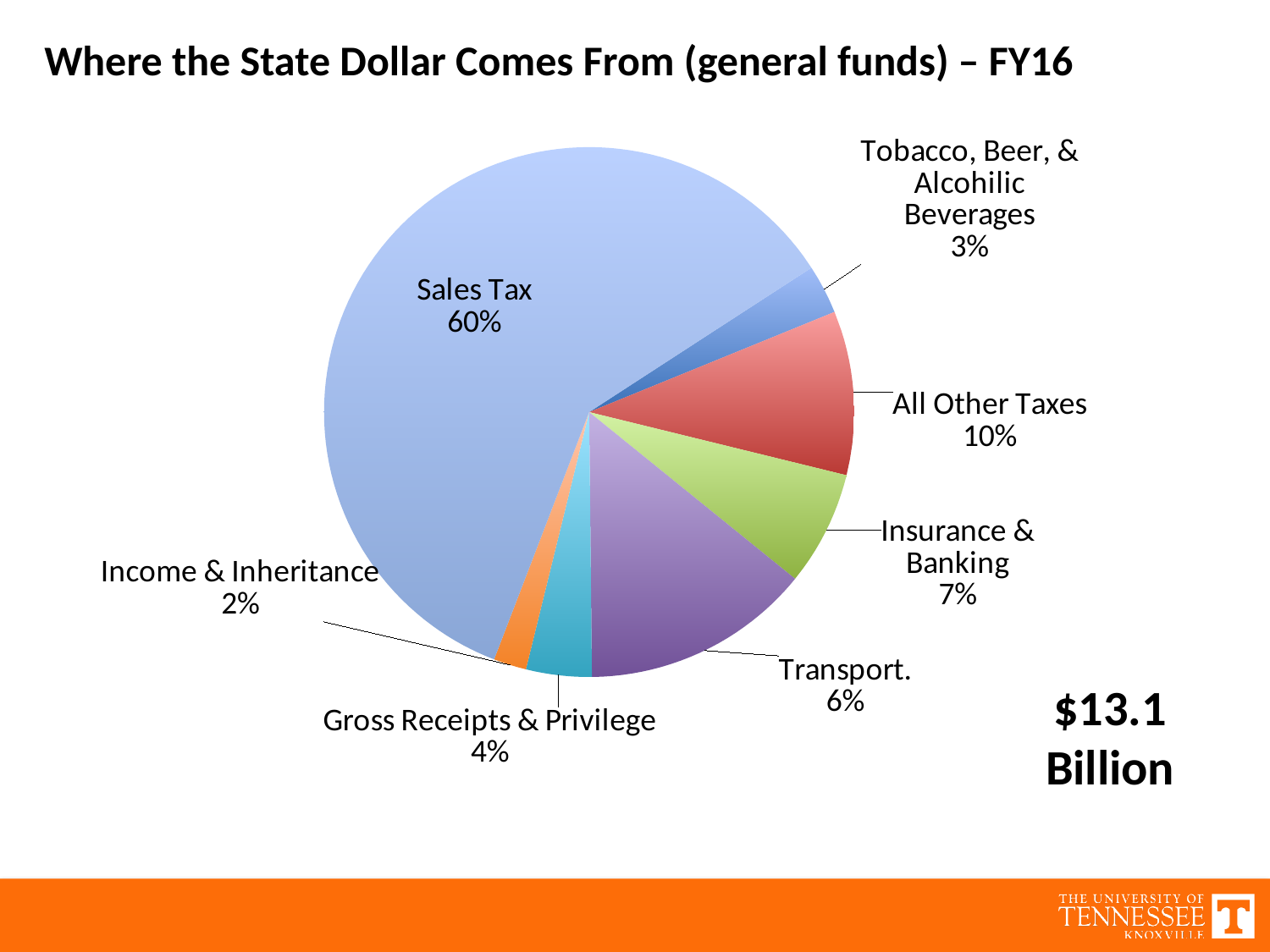
How many categories are shown in the pie chart? 7 What is the value shown for All Other Taxes? 10% What share of the pie does Sales Tax represent? 60% What type of chart is shown on the slide? Pie chart Which category has the smallest slice of the pie? Income & Inheritance What is the value for Tobacco, Beer, & Alcohilic Beverages? 3% What is the difference between the Sales Tax share and the All Other Taxes share? 50% Which category has the largest slice of the pie? Sales Tax What percentage is shown for Insurance & Banking? 7% What percentage is shown for Gross Receipts & Privilege? 4% What is the value for Transport.? 6%